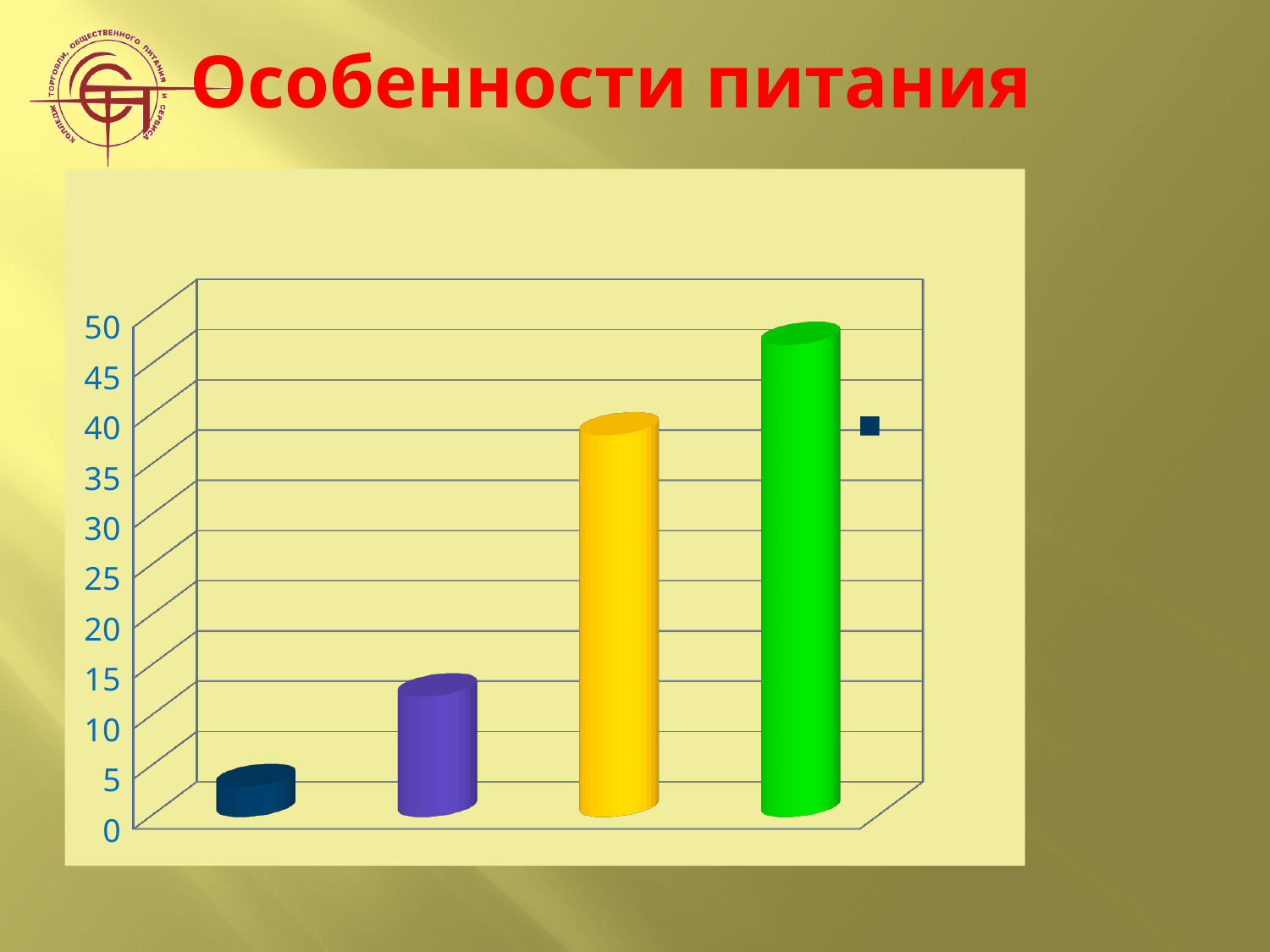
Is the value of the third (yellow) bar greater or less than 35? greater What kind of chart is shown on the slide? bar chart Which is larger, the yellow bar or the purple bar? the yellow bar Which bar is the tallest in the chart? the green bar (fourth from the left) Is the value of the second (purple) bar greater or less than 10? greater Do the bar values rise or fall from left to right across the chart? rise Is the value of the fourth (green) bar greater or less than 45? greater How many bars are plotted in the chart? 4 Which bar is the shortest in the chart? the dark blue bar (first from the left) What is the title of the slide containing the chart? Особенности питания